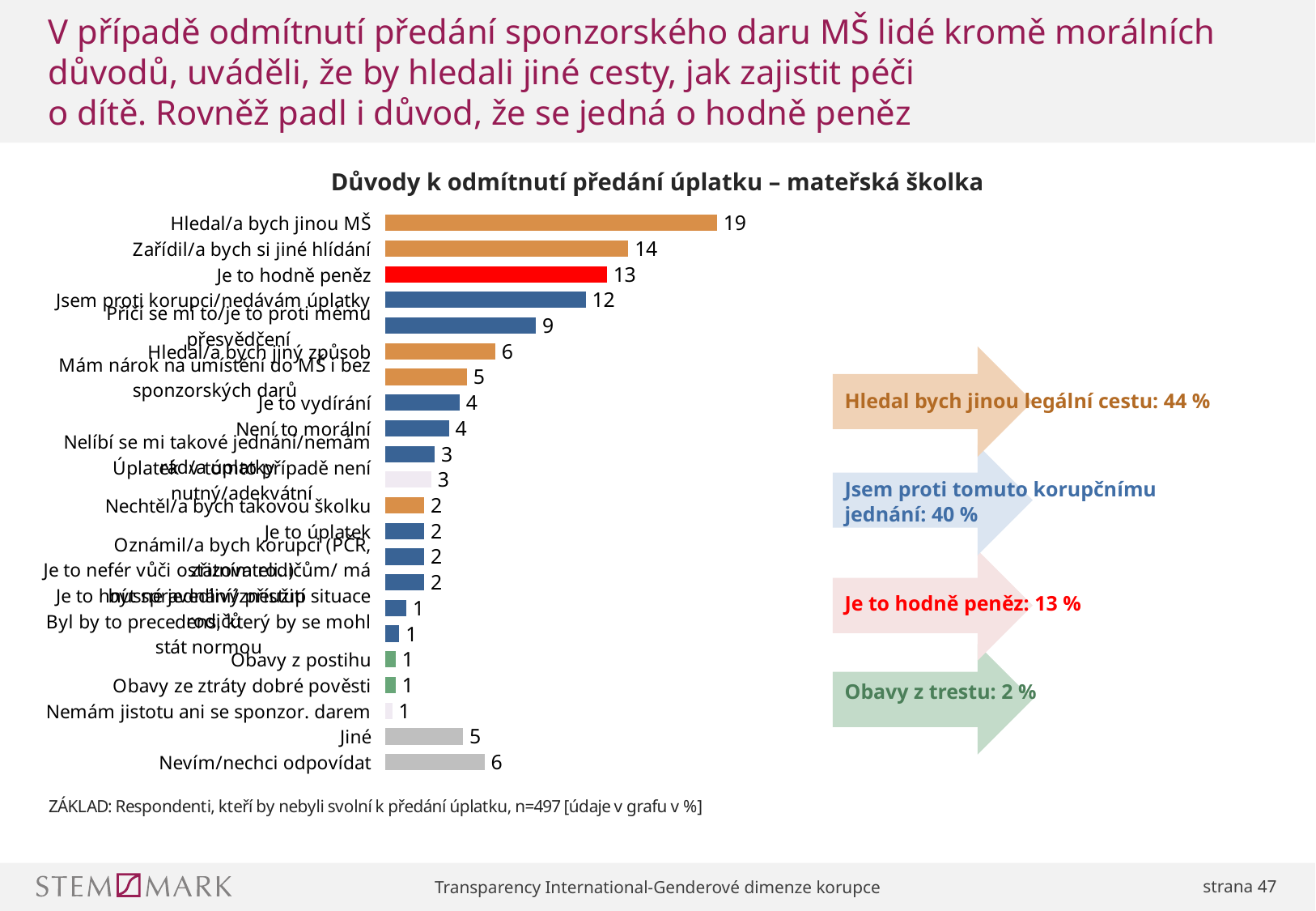
What is the value for "Hledal/a bych jinou MŠ"? 19 What is the value for "Zařídil/a bych si jiné hlídání"? 14 What is the difference between the values for "Hledal/a bych jinou MŠ" and "Zařídil/a bych si jiné hlídání"? 5 What colour is the bar for "Je to hodně peněz"? red What is the value for "Jiné"? 5 What is the title of the chart? Důvody k odmítnutí předání úplatku – mateřská školka What is the value for "Nevím/nechci odpovídat"? 6 Which is larger, the value for "Je to hodně peněz" or for "Jsem proti korupci/nedávám úplatky"? Je to hodně peněz What is the value for "Jsem proti korupci/nedávám úplatky"? 12 What type of chart is shown on the slide? bar chart What is the value for "Je to hodně peněz"? 13 Which category has the highest value? Hledal/a bych jinou MŠ